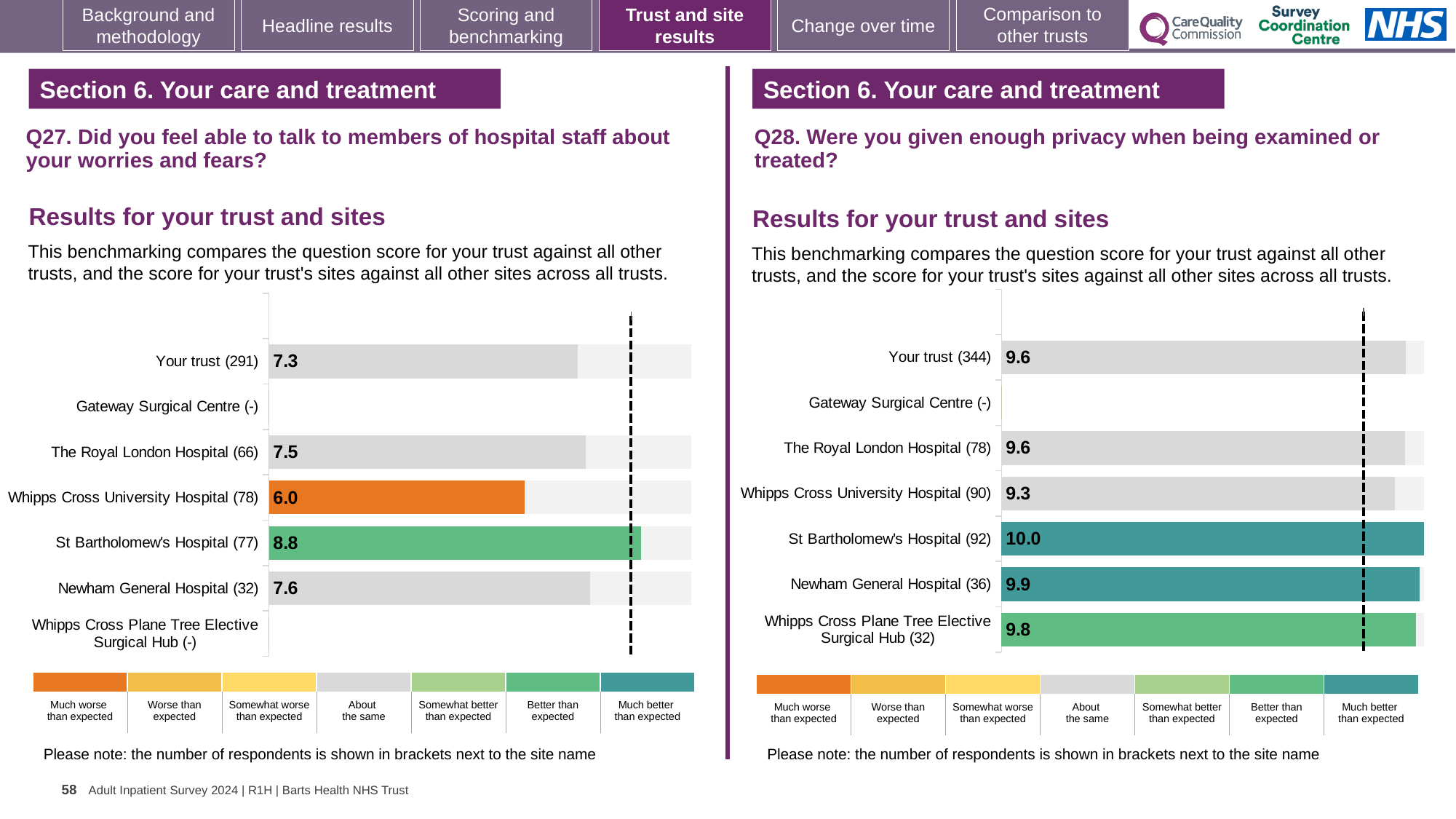
On the Q27 chart (left), what is the score for Whipps Cross University Hospital? 6.0 On the Q28 chart (right), what is the score for St Bartholomew's Hospital? 10.0 On the Q27 chart (left), what is the difference between the scores for St Bartholomew's Hospital and Whipps Cross University Hospital? 2.8 On the Q28 chart (right), what is the difference between the scores for Your trust and Whipps Cross University Hospital? 0.3 On the Q27 chart (left), which site has the lowest score among those with a score shown? Whipps Cross University Hospital On the Q27 chart (left), what is the score for Your trust? 7.3 On the Q27 chart (left), which site has the highest score? St Bartholomew's Hospital On the Q27 chart (left), how many respondents are shown for Newham General Hospital? 32 On the Q28 chart (right), which is larger: the score for Newham General Hospital or the score for The Royal London Hospital? Newham General Hospital On the Q28 chart (right), which site has the lowest score among those with a score shown? Whipps Cross University Hospital On the Q28 chart (right), what is the score for Whipps Cross Plane Tree Elective Surgical Hub? 9.8 What kind of chart is used on the Q27 chart (left)? Bar chart